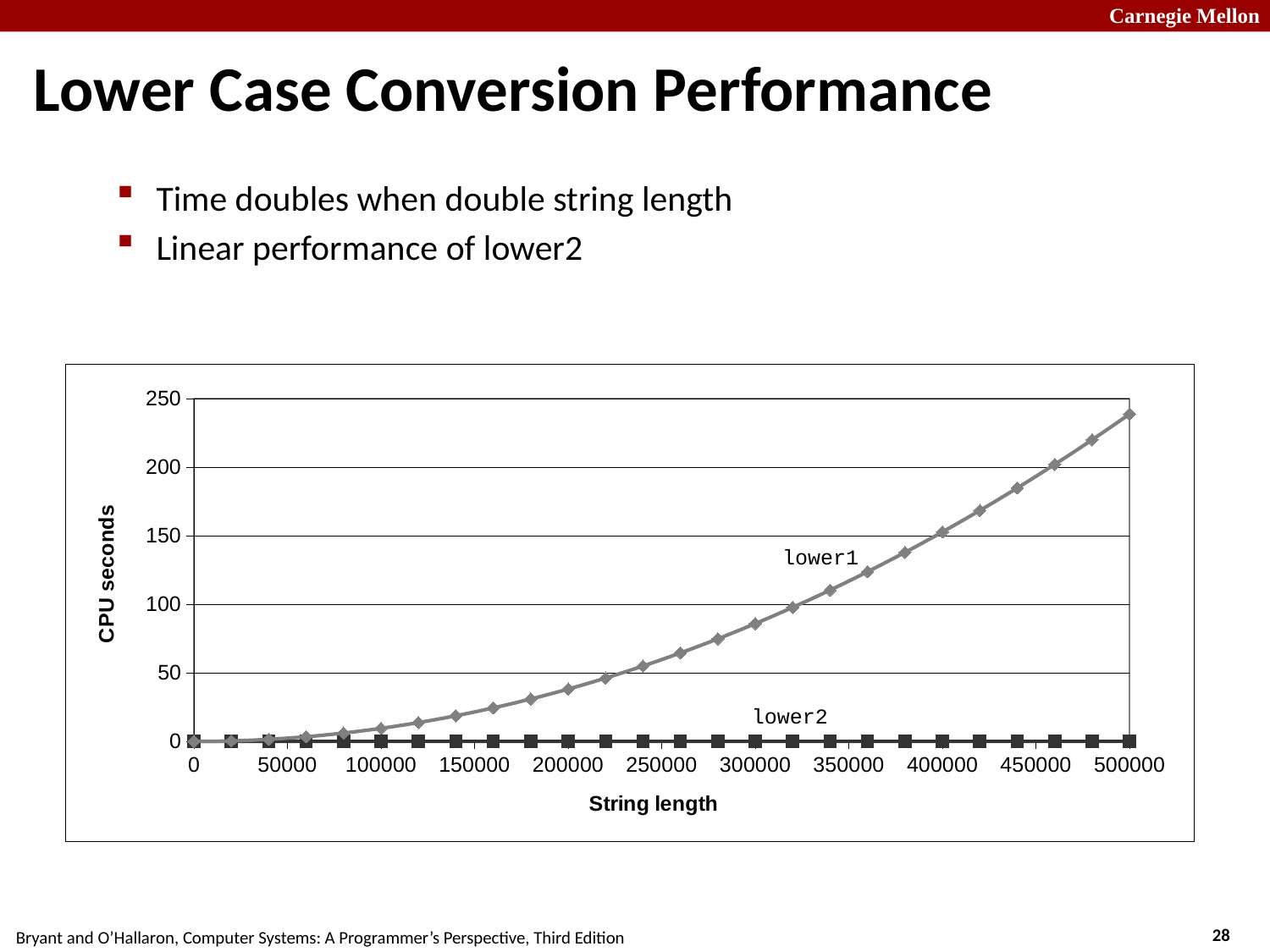
Do the values for lower1 rise or fall as string length increases? rise What is the label of the y axis? CPU seconds What are the names of the two series plotted on the chart? lower1 and lower2 Is the value for lower1 at string length 100000 greater or less than 50? less At string length 500000, which series has the larger CPU seconds value, lower1 or lower2? lower1 How many data series are plotted on the chart? 2 Is the value for lower1 at string length 400000 greater or less than 100? greater Is the value for lower1 at string length 500000 greater or less than 200? greater What kind of chart is shown on the slide? line chart Which series reaches the highest CPU seconds value on the chart? lower1